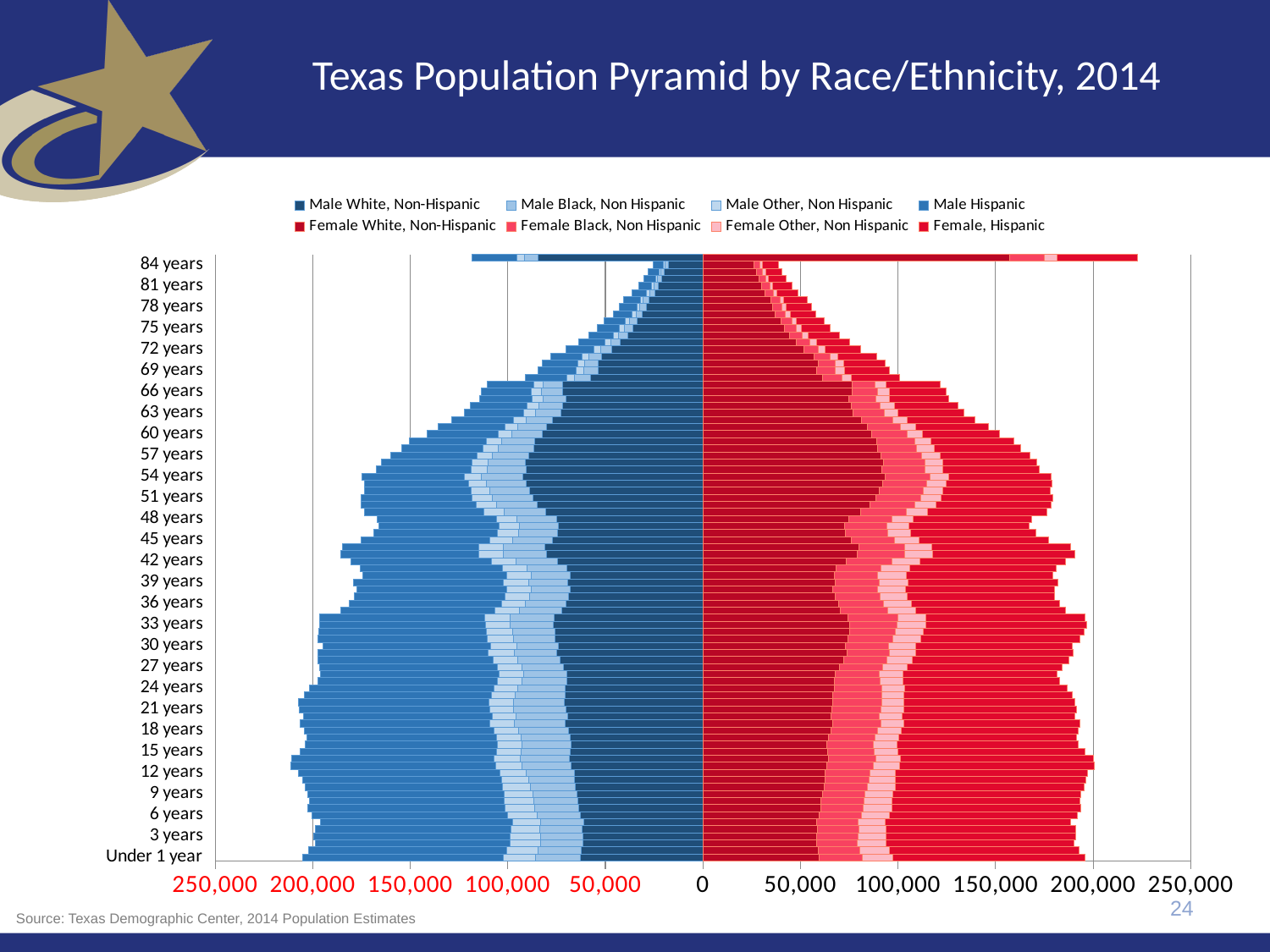
Is the total male value for 66 years greater or less than 150,000? less How many series does the legend list? 8 Is the total male value for 81 years greater or less than 50,000? less What kind of chart is shown on the slide? bar chart Which colour family is used for the female series in the chart? red Is the total male value for 12 years greater or less than 200,000? greater Which is larger at 84 years, the total male bar or the total female bar? female What is the title of the chart? Texas Population Pyramid by Race/Ethnicity, 2014